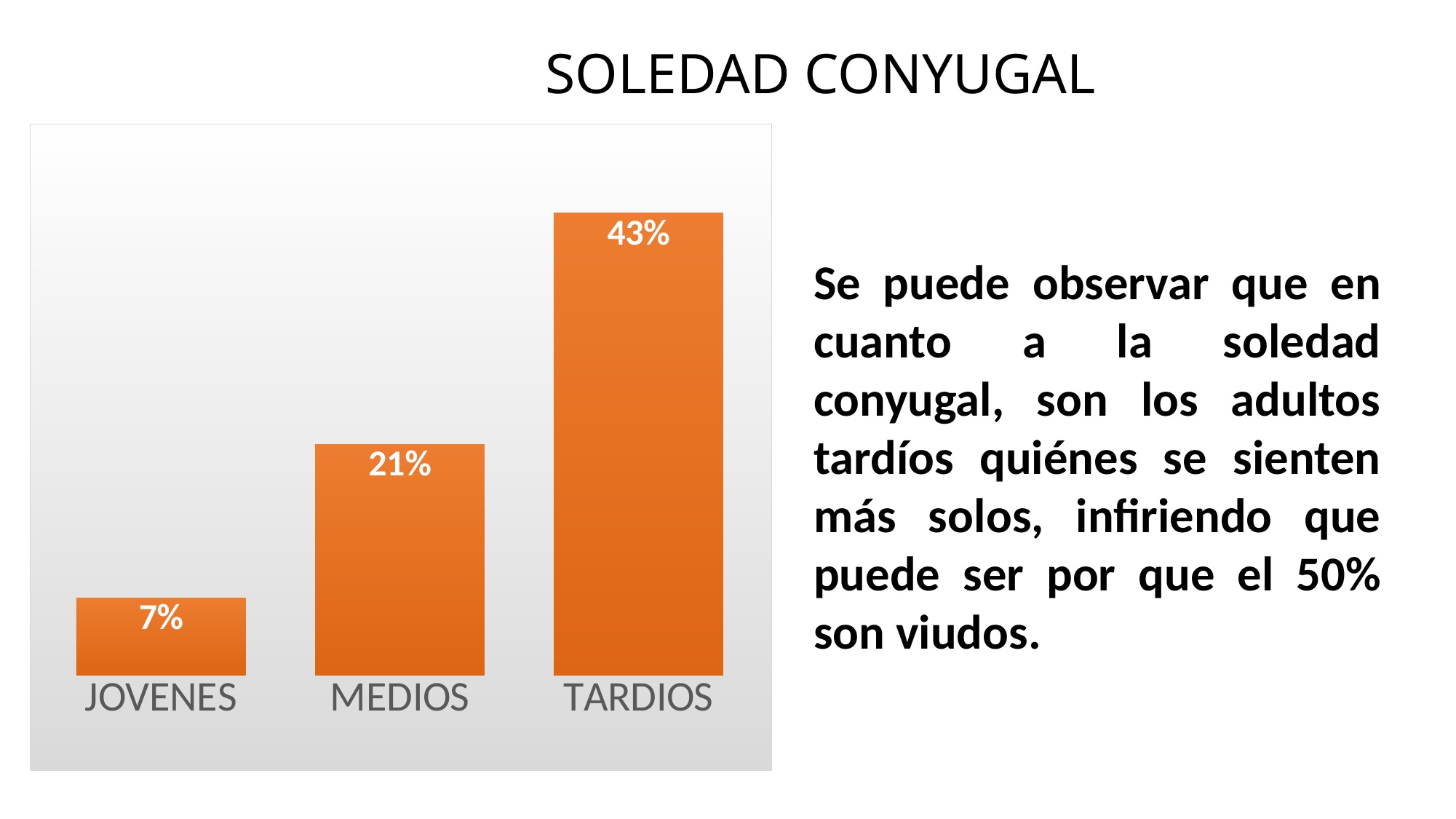
What is the difference between the values for TARDIOS and MEDIOS? 22% How many categories are shown in the chart? 3 What is the value for TARDIOS? 43% What is the title of the slide containing the chart? SOLEDAD CONYUGAL What is the value for MEDIOS? 21% What kind of chart is shown on the slide? Bar chart Which category has the lowest value? JOVENES Which category has the highest value? TARDIOS Do the values rise or fall from JOVENES to TARDIOS? Rise What is the difference between the values for MEDIOS and JOVENES? 14% What is the value for JOVENES? 7% Which is larger, the value for MEDIOS or the value for JOVENES? MEDIOS